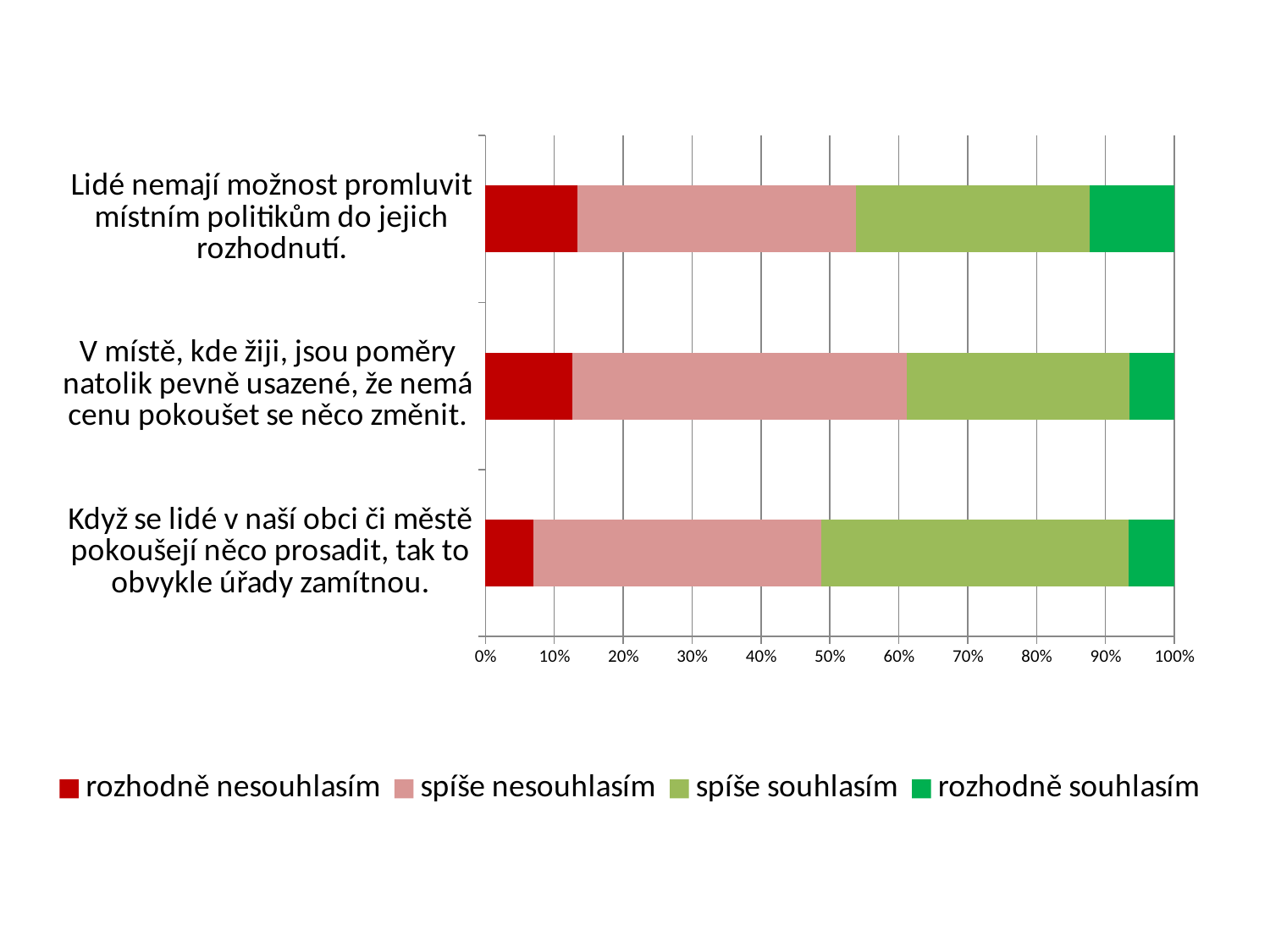
What is the total of the stacked bar for "Když se lidé v naší obci či městě pokoušejí něco prosadit, tak to obvykle úřady zamítnou."? 100% How many series does the legend list? 4 What kind of chart is shown on the slide? stacked bar chart Is the value of "rozhodně nesouhlasím" for "Když se lidé v naší obci či městě pokoušejí něco prosadit, tak to obvykle úřady zamítnou." greater or less than 10%? less Which statement has the largest "spíše souhlasím" segment? Když se lidé v naší obci či městě pokoušejí něco prosadit, tak to obvykle úřady zamítnou. What is the first entry listed in the legend? rozhodně nesouhlasím Which statement has the smallest "rozhodně nesouhlasím" segment? Když se lidé v naší obci či městě pokoušejí něco prosadit, tak to obvykle úřady zamítnou. Is the value of "rozhodně nesouhlasím" for "Lidé nemají možnost promluvit místním politikům do jejich rozhodnutí." greater or less than 10%? greater How many statements (categories) are plotted on the chart? 3 Is the value of "rozhodně souhlasím" for "V místě, kde žiji, jsou poměry natolik pevně usazené, že nemá cenu pokoušet se něco změnit." greater or less than 10%? less Which is larger: the "spíše nesouhlasím" segment for "V místě, kde žiji, jsou poměry natolik pevně usazené, že nemá cenu pokoušet se něco změnit." or for "Lidé nemají možnost promluvit místním politikům do jejich rozhodnutí."? V místě, kde žiji, jsou poměry natolik pevně usazené, že nemá cenu pokoušet se něco změnit. Which statement has the largest "rozhodně souhlasím" segment? Lidé nemají možnost promluvit místním politikům do jejich rozhodnutí.